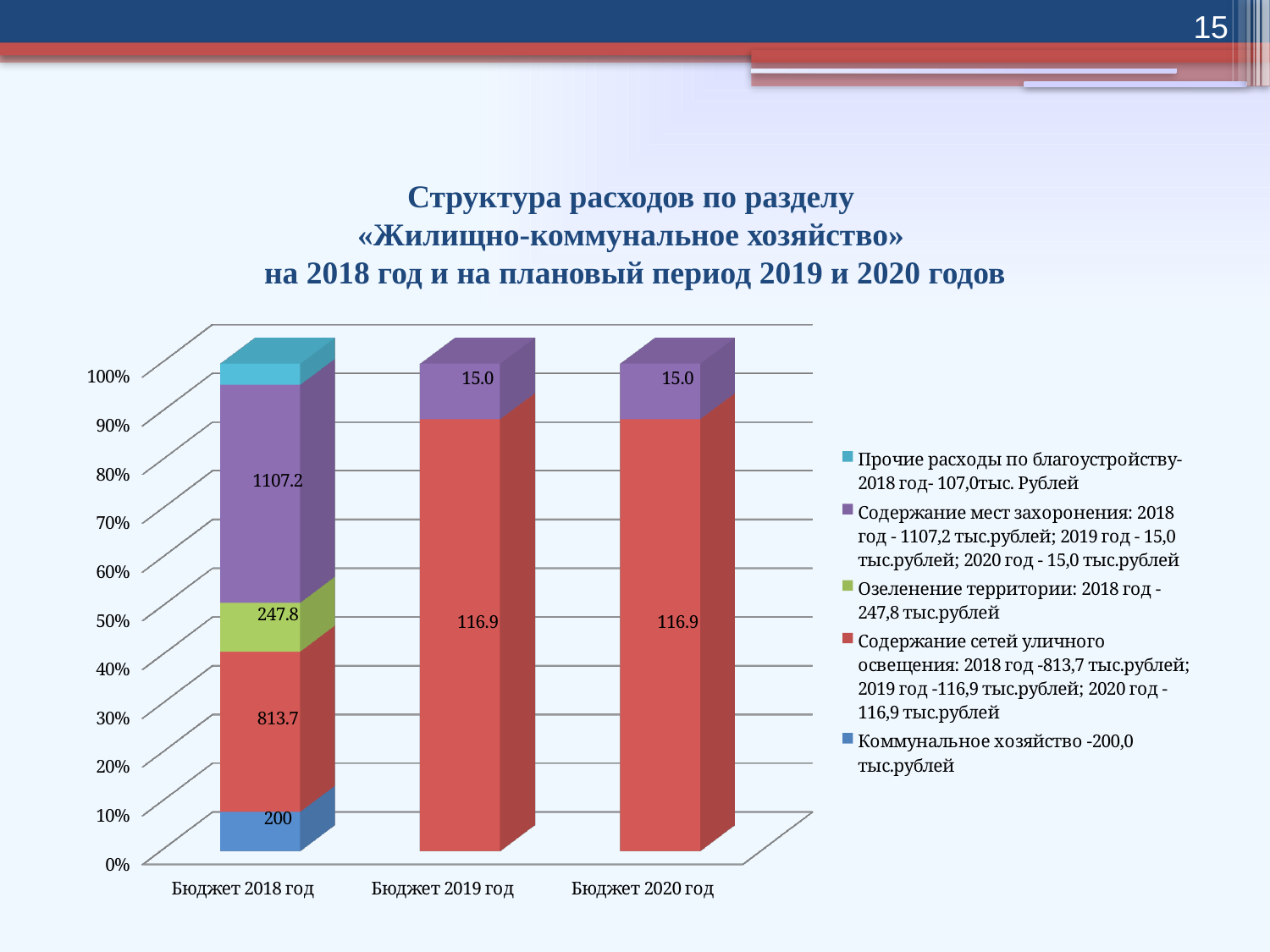
How many series does the legend list? 5 What value is shown for Содержание мест захоронения in the Бюджет 2018 год bar? 1107.2 What value is shown for Коммунальное хозяйство in the Бюджет 2018 год bar? 200 In the Бюджет 2018 год bar, which is larger: Содержание сетей уличного освещения or Озеленение территории? Содержание сетей уличного освещения What value is shown for Озеленение территории in the Бюджет 2018 год bar? 247.8 What kind of chart is shown on the slide? Stacked bar chart What value is shown for Содержание сетей уличного освещения in the Бюджет 2019 год bar? 116.9 What value is shown for Содержание мест захоронения in the Бюджет 2020 год bar? 15.0 What is the difference between Содержание мест захоронения (1107.2) and Озеленение территории (247.8) in the Бюджет 2018 год bar? 859.4 How many budget years (categories) are shown on the x axis? 3 Which labelled segment of the Бюджет 2018 год bar has the largest value? Содержание мест захоронения (1107.2) What is the total of the labelled values in the Бюджет 2019 год bar? 131.9